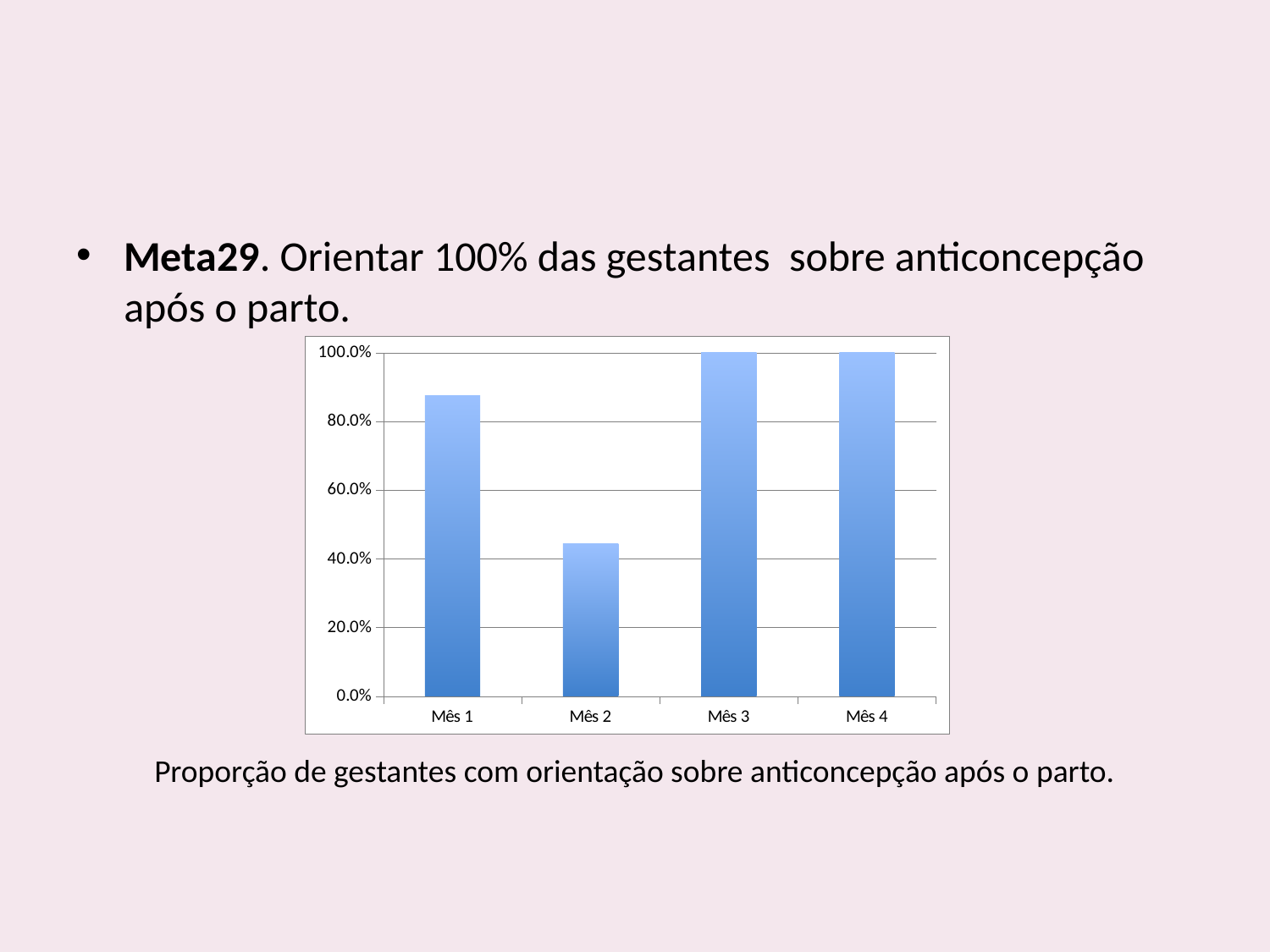
How many categories (months) are shown on the x axis of the chart? 4 Which months reach 100.0% in the chart? Mês 3 and Mês 4 Is the value for Mês 2 greater or less than 40.0%? greater What is the value for Mês 4 in the chart? 100.0% Which is larger, the value for Mês 1 or the value for Mês 2? Mês 1 What is the highest value shown on the y axis of the chart? 100.0% What caption is written below the chart? Proporção de gestantes com orientação sobre anticoncepção após o parto. Is the value for Mês 1 greater or less than 80.0%? greater What kind of chart is shown on the slide? Bar chart Is the value for Mês 2 greater or less than 60.0%? less Which month has the lowest value in the chart? Mês 2 What is the value for Mês 3 in the chart? 100.0%